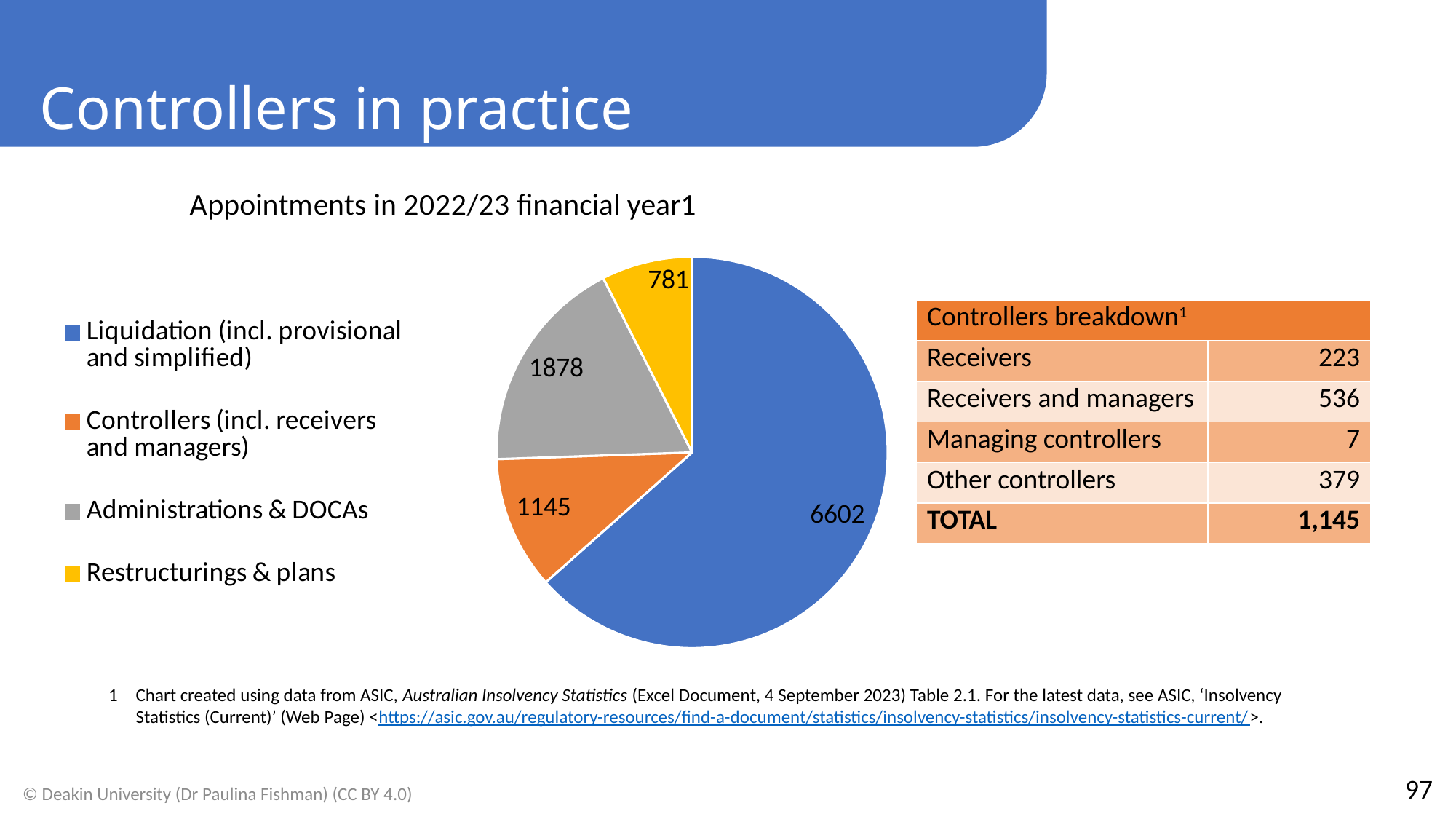
Which category has the smallest slice of the pie? Restructurings & plans What is the title of the chart? Appointments in 2022/23 financial year1 Which category has the largest slice of the pie? Liquidation (incl. provisional and simplified) What colour is the slice for Restructurings & plans? yellow What is the difference between the values for Administrations & DOCAs and Controllers (incl. receivers and managers)? 733 What is the value for Controllers (incl. receivers and managers)? 1145 What is the value for Administrations & DOCAs? 1878 Which is larger, Administrations & DOCAs or Controllers (incl. receivers and managers)? Administrations & DOCAs What type of chart is shown on the slide? pie chart What is the value for Restructurings & plans? 781 How many slices does the pie chart have? 4 What is the value for Liquidation (incl. provisional and simplified)? 6602